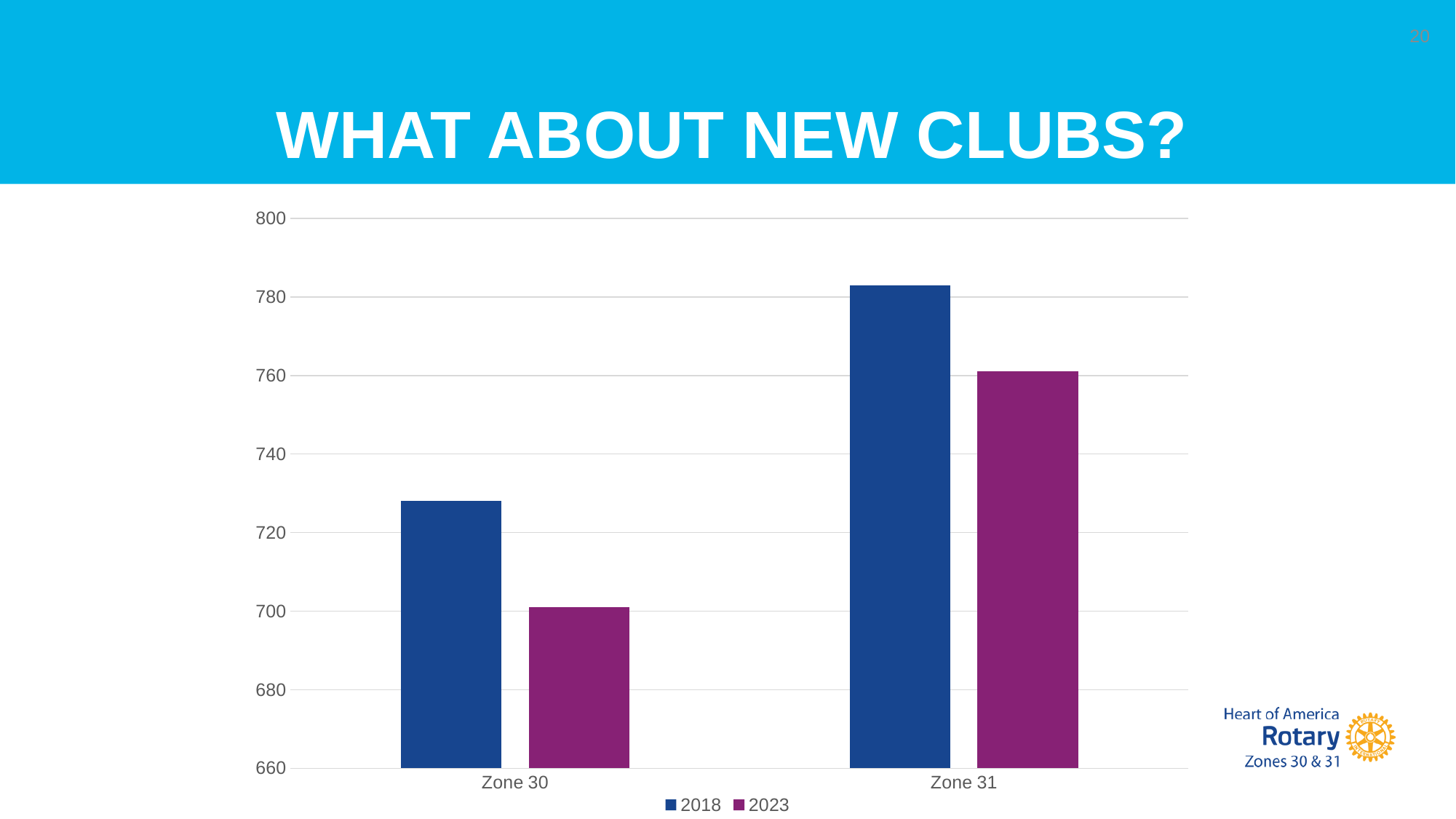
Is the 2018 value for Zone 31 greater or less than 760? greater How many categories are shown on the x axis? 2 Is the 2018 value for Zone 30 greater or less than 720? greater Which bar is the shortest in the chart? Zone 30, 2023 For Zone 30, which is larger, the 2018 value or the 2023 value? 2018 Is the 2023 value for Zone 31 greater or less than 780? less Which series is shown in purple? 2023 Which bar is the tallest in the chart? Zone 31, 2018 How many series does the legend list? 2 What kind of chart is shown on the slide? bar chart What is the title of the slide containing the chart? WHAT ABOUT NEW CLUBS?